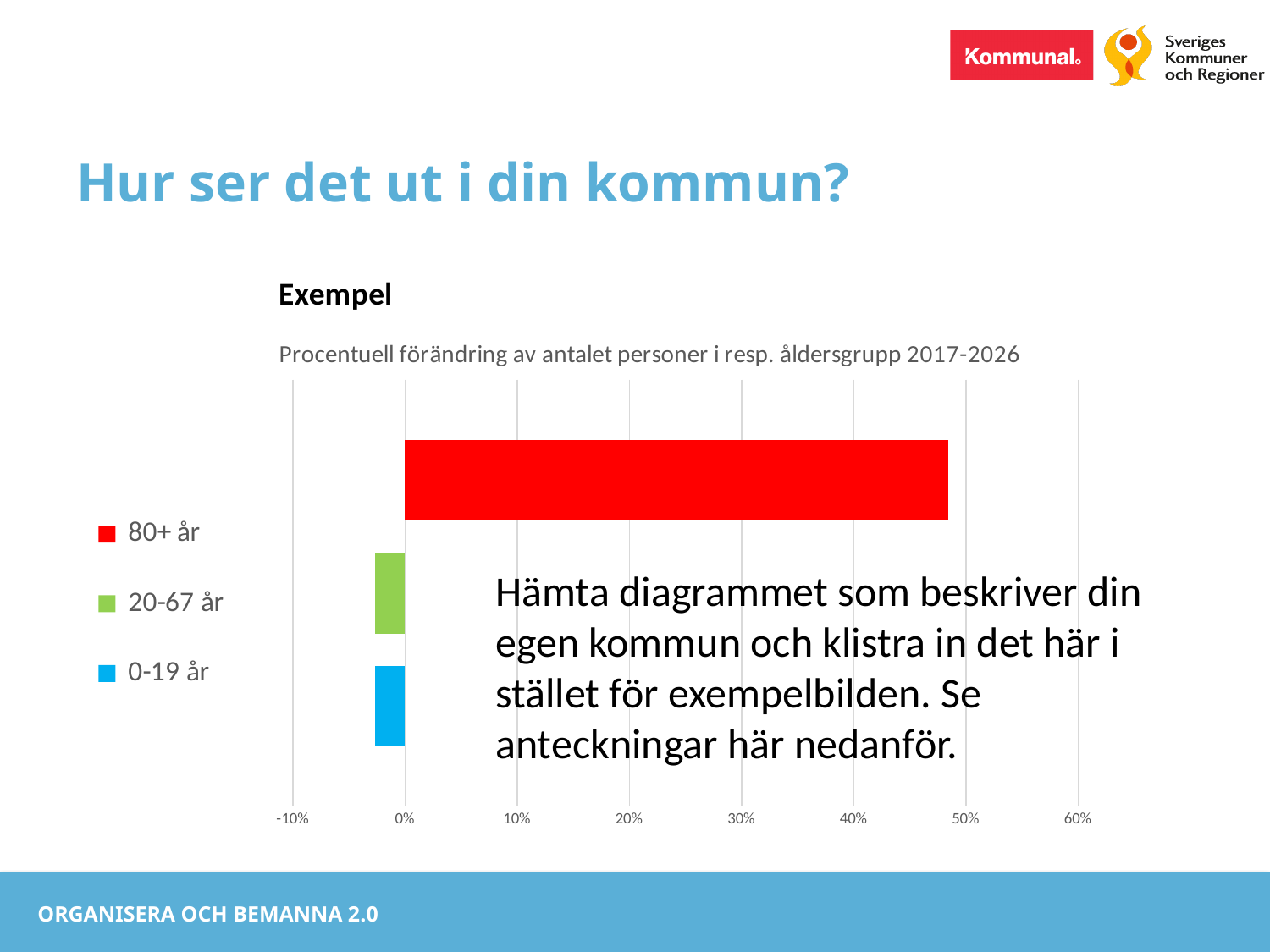
Is the value for 80+ år greater or less than 50%? less Which is larger, the value for 80+ år or the value for 0-19 år? 80+ år What is the title of the chart? Procentuell förändring av antalet personer i resp. åldersgrupp 2017-2026 How many series does the chart legend list? 3 Is the value for 20-67 år greater or less than 0%? less Which age group has the highest value in the chart? 80+ år Is the value for 80+ år greater or less than 40%? greater What kind of chart is shown on the slide? bar chart Which colour represents the 20-67 år series in the chart? green How many bars are plotted in the chart? 3